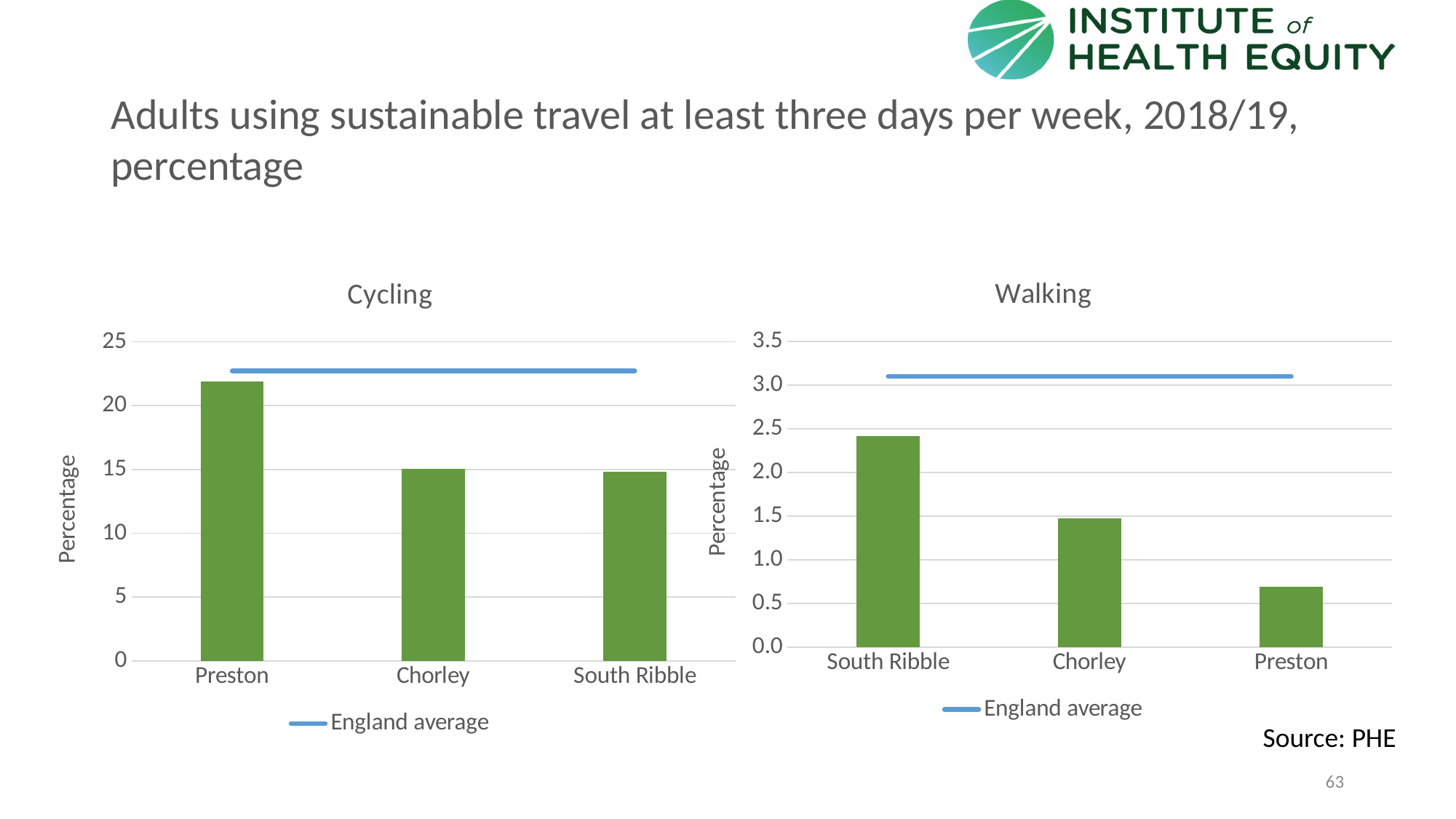
In the Walking chart, which area has the highest percentage? South Ribble In the Walking chart, which is larger, the value for Chorley or the value for Preston? Chorley In the Cycling chart, is the value for South Ribble greater or less than 20? less In the Cycling chart, which area has the highest percentage? Preston In the Cycling chart, is the value for Preston greater or less than 20? greater How many areas are shown in the Walking chart? 3 In the Walking chart, do the bar values rise or fall from left to right? fall In the Walking chart, is the value for South Ribble greater or less than 2.0? greater In the Walking chart, which area has the lowest percentage? Preston What does the blue line in the Cycling chart represent, according to the legend? England average What kind of chart is the Cycling chart? bar chart